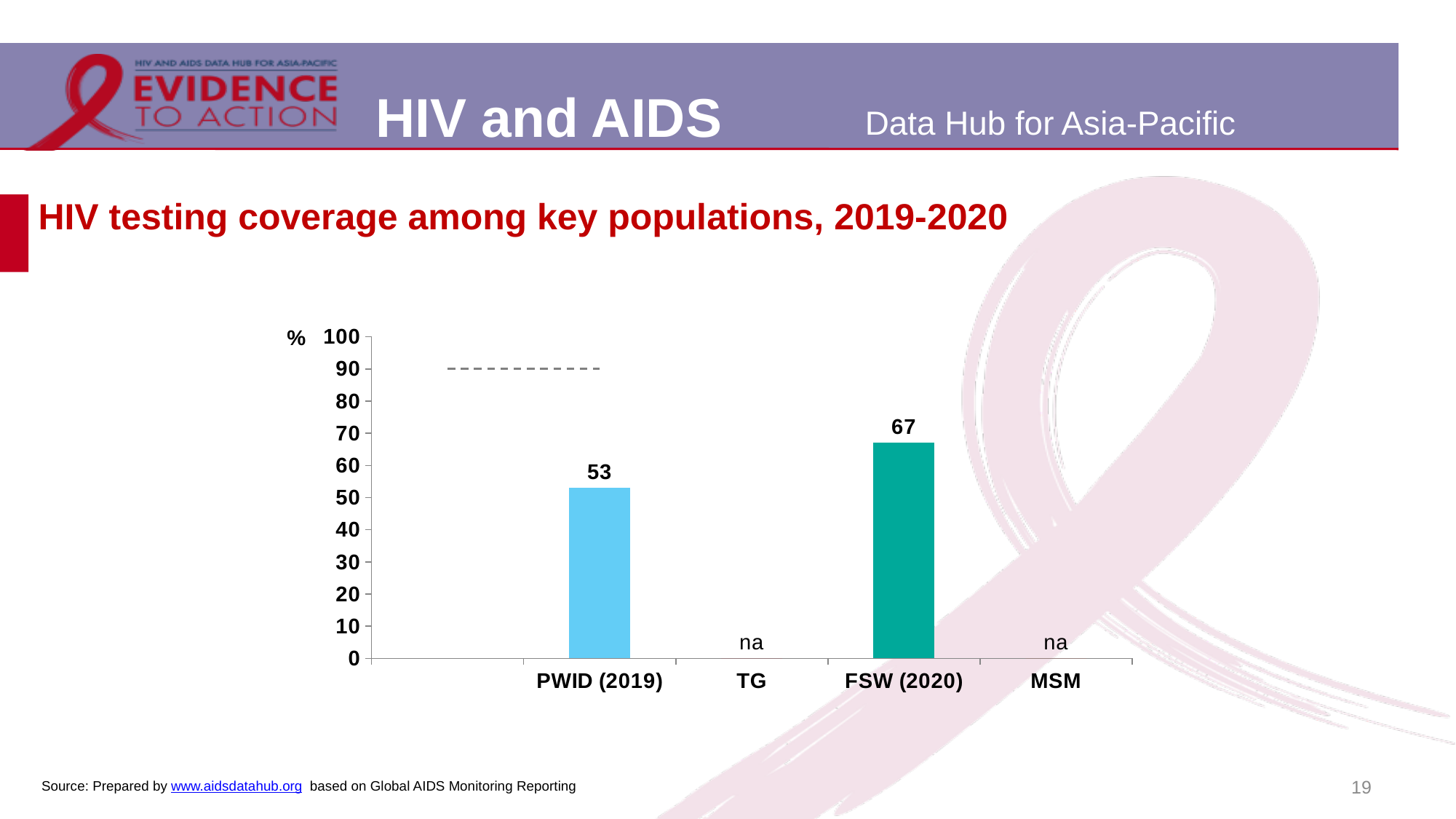
What is the difference between the values for FSW (2020) and PWID (2019)? 14 What kind of chart is shown on the slide? Bar chart Is the value for FSW (2020) greater or less than 60? greater What is the HIV testing coverage value for PWID (2019)? 53 Is the value for PWID (2019) greater or less than 60? less What is shown for MSM on the chart? na How many key population categories are shown on the x axis? 4 Which is larger, the value for PWID (2019) or the value for FSW (2020)? FSW (2020) Which key population has the highest plotted HIV testing coverage? FSW (2020) What is the title of the chart on the slide? HIV testing coverage among key populations, 2019-2020 What is the HIV testing coverage value for FSW (2020)? 67 What is shown for TG on the chart? na